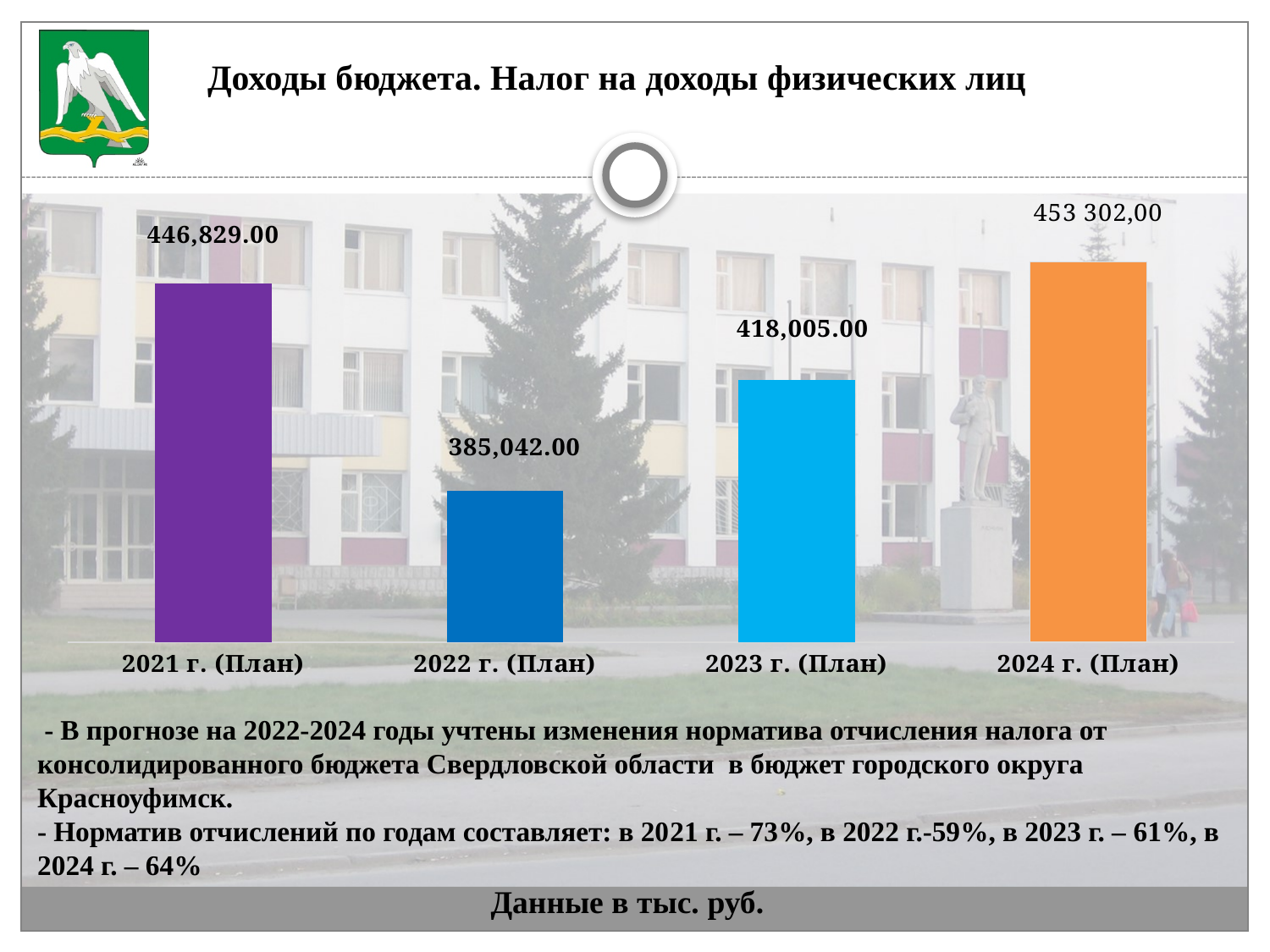
What is the difference between the values for 2023 г. (План) and 2022 г. (План)? 32,963.00 Which year has the lowest value? 2022 г. (План) How many bars are shown in the chart? 4 What kind of chart is shown on the slide? bar chart What is the difference between the values for 2021 г. (План) and 2022 г. (План)? 61,787.00 What is the value for 2023 г. (План)? 418,005.00 Which year has the highest value? 2024 г. (План) What is the value for 2024 г. (План)? 453 302,00 Which is larger, the value for 2023 г. (План) or 2022 г. (План)? 2023 г. (План) What is the value for 2021 г. (План)? 446,829.00 What is the value for 2022 г. (План)? 385,042.00 Do the values rise or fall from 2022 г. (План) to 2024 г. (План)? rise